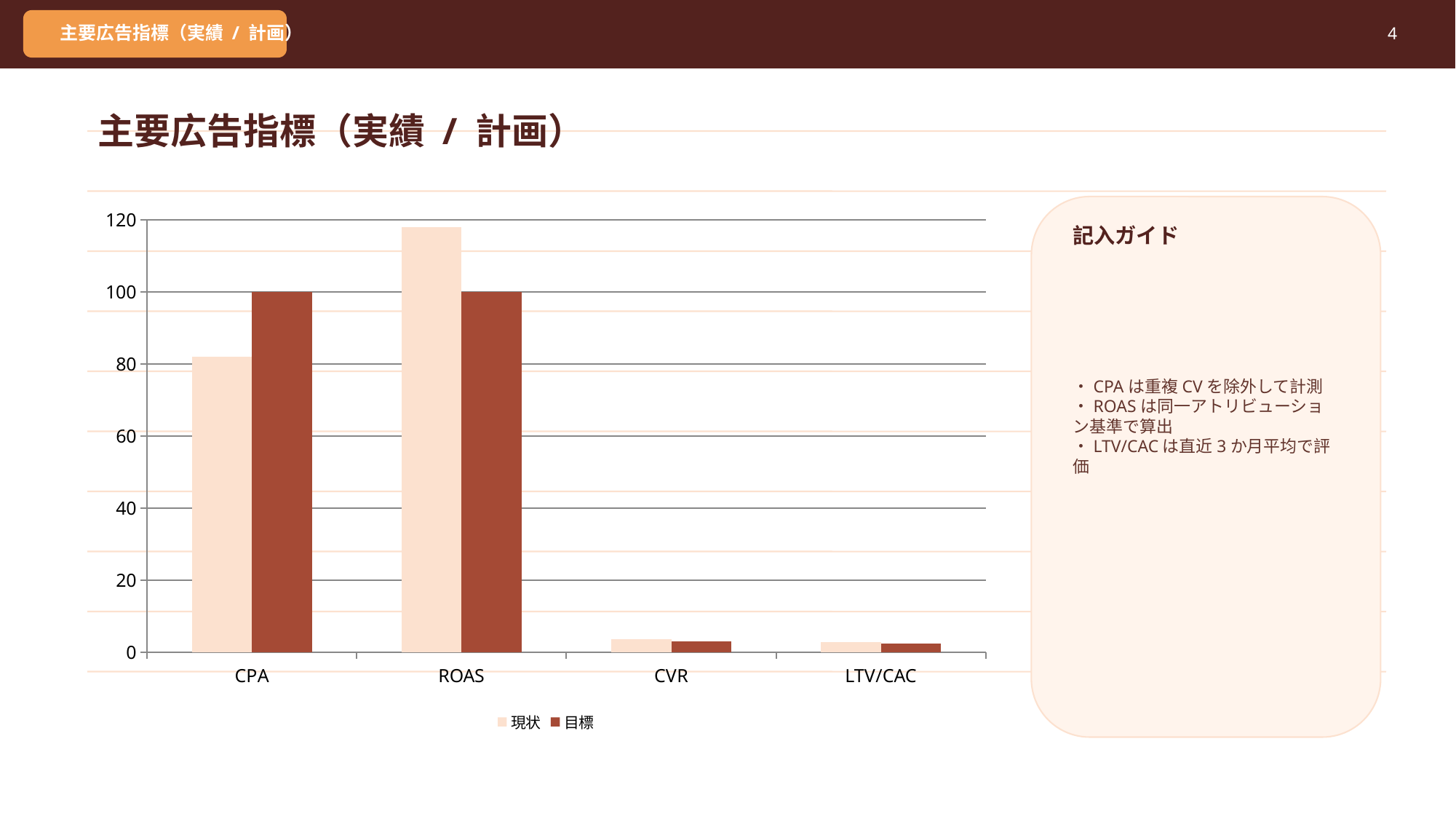
What are the two series names listed in the chart legend? 現状 and 目標 What is the 目標 value for CPA? 100 Is the 現状 value for ROAS greater or less than 100? greater Which category has the highest 現状 value? ROAS Is the 現状 value for CVR greater or less than 20? less Is the 現状 value for CPA greater or less than 100? less What is the 目標 value for ROAS? 100 How many series does the chart legend list? 2 How many categories are shown on the x axis of the chart? 4 For CPA, which is larger, the 現状 value or the 目標 value? 目標 What kind of chart is shown on the slide? bar chart For ROAS, which is larger, the 現状 value or the 目標 value? 現状